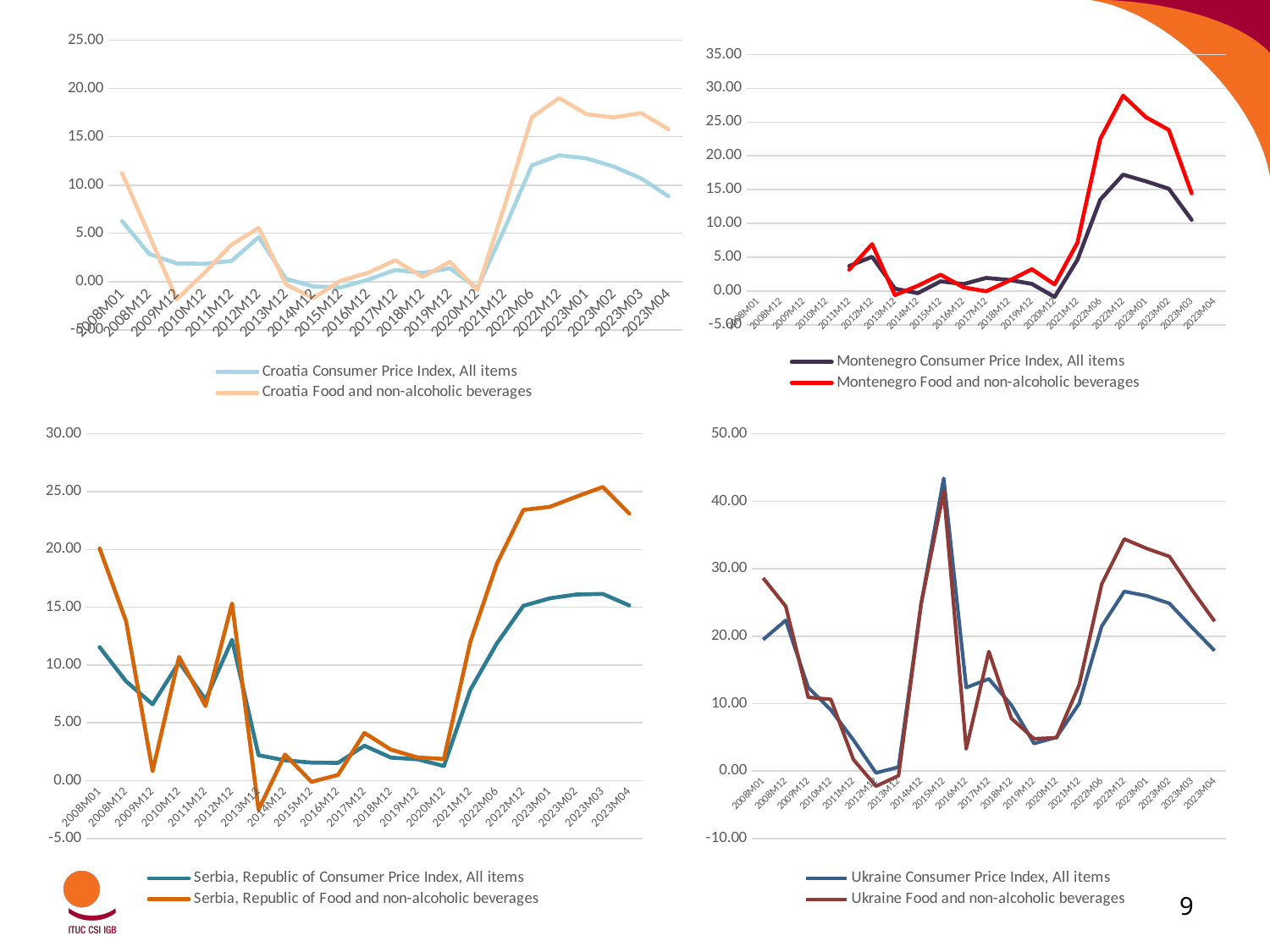
In the bottom-left chart (Serbia), which series is higher at 2008M01: Serbia, Republic of Consumer Price Index, All items or Serbia, Republic of Food and non-alcoholic beverages? Serbia, Republic of Food and non-alcoholic beverages In the bottom-right chart (Ukraine), is the value of Ukraine Consumer Price Index, All items at 2015M12 greater or less than 40.00? greater In the bottom-right chart (Ukraine), at which x-axis point does Ukraine Consumer Price Index, All items reach its highest value? 2015M12 In the bottom-right chart (Ukraine), does Ukraine Consumer Price Index, All items rise or fall from 2022M12 to 2023M04? fall In the bottom-left chart (Serbia), is the value of Serbia, Republic of Food and non-alcoholic beverages at 2023M03 greater or less than 25.00? greater In the top-left chart (Croatia), is the value of Croatia Consumer Price Index, All items at 2022M12 greater or less than 15.00? less How many series does the legend of the top-right chart (Montenegro) list? 2 In the top-right chart (Montenegro), which series is higher at 2022M12: Montenegro Consumer Price Index, All items or Montenegro Food and non-alcoholic beverages? Montenegro Food and non-alcoholic beverages How many x-axis categories are shown in the bottom-left chart (Serbia)? 21 What type of chart is the top-left chart (Croatia)? Line chart